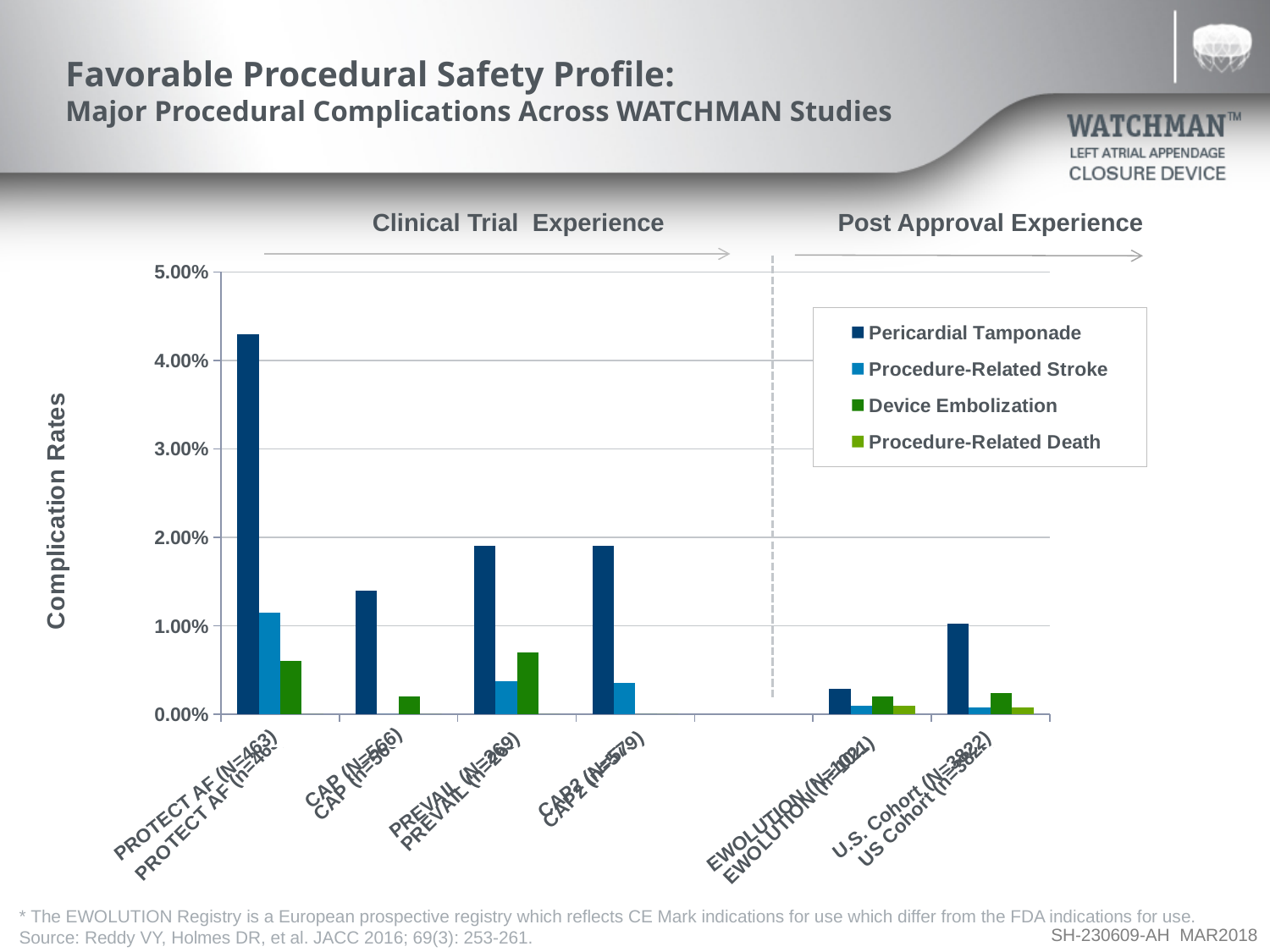
How many series does the chart legend list? 4 Is the Pericardial Tamponade rate for CAP greater or less than 1.00%? greater Which is larger: the Pericardial Tamponade rate for PROTECT AF or for CAP? PROTECT AF Which study has the highest Pericardial Tamponade rate? PROTECT AF What is the label of the vertical axis? Complication Rates How many studies (categories) are plotted along the x axis? 6 For PREVAIL, which is larger: the Device Embolization rate or the Procedure-Related Stroke rate? Device Embolization Which study has the lowest Pericardial Tamponade rate? EWOLUTION Which legend series is shown in dark blue? Pericardial Tamponade What kind of chart is shown on the slide? Bar chart Is the Pericardial Tamponade rate for PROTECT AF greater or less than 4.00%? greater Is the Pericardial Tamponade rate for EWOLUTION greater or less than 1.00%? less